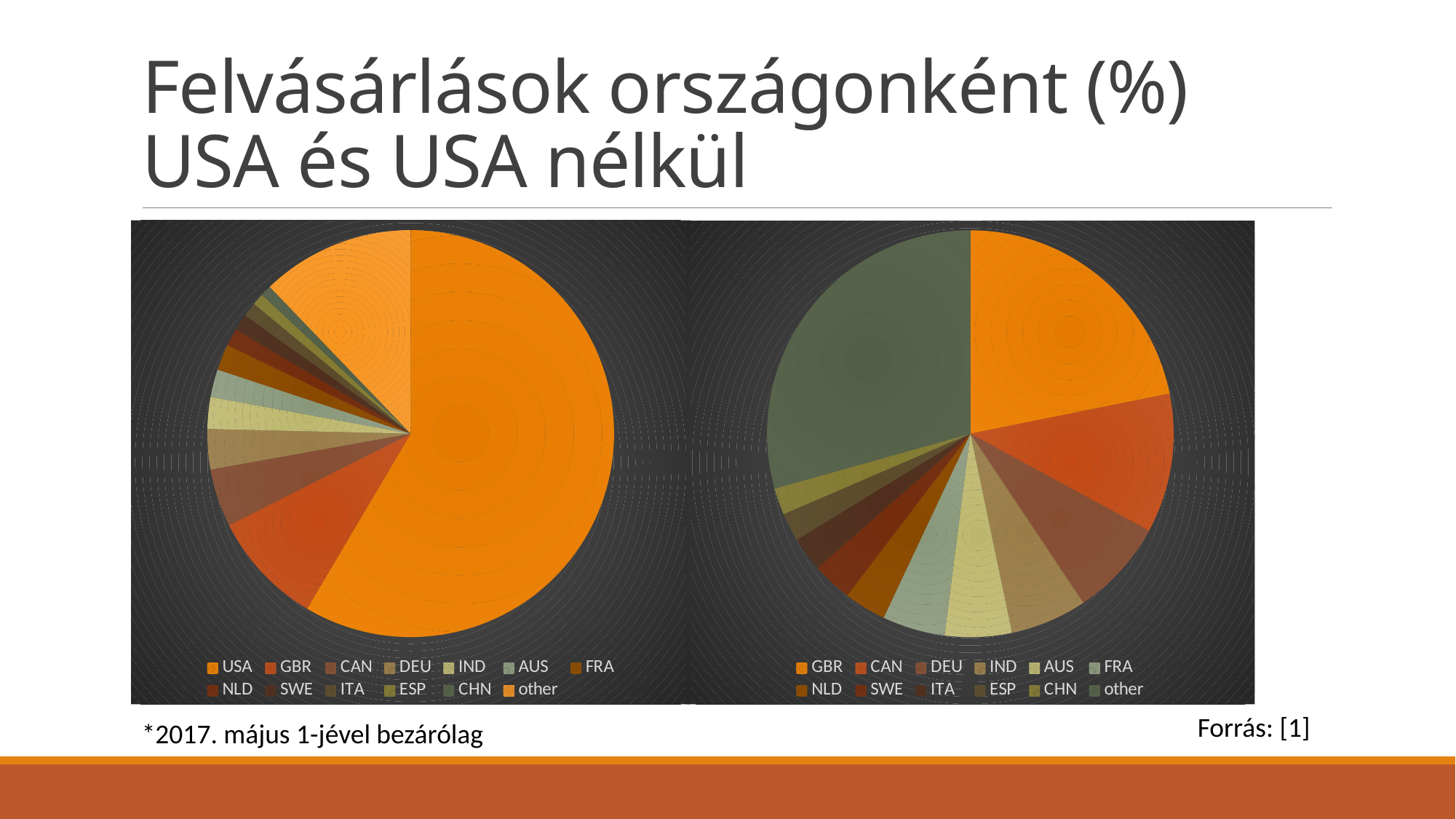
In the right pie chart, which slice is larger, GBR or CAN? GBR How many categories does the legend of the left pie chart list? 13 In the left pie chart, which category has the largest slice? USA In the left pie chart, which slice is larger, GBR or CHN? GBR In the right pie chart, which category has the largest slice? other What is the title of the slide containing the two pie charts? Felvásárlások országonként (%) USA és USA nélkül What kind of chart is the right chart on the slide? pie chart In the left pie chart, which slice is larger, USA or GBR? USA What kind of chart is the left chart on the slide? pie chart Which category appears in the legend of the left pie chart but not in the legend of the right pie chart? USA How many categories does the legend of the right pie chart list? 12